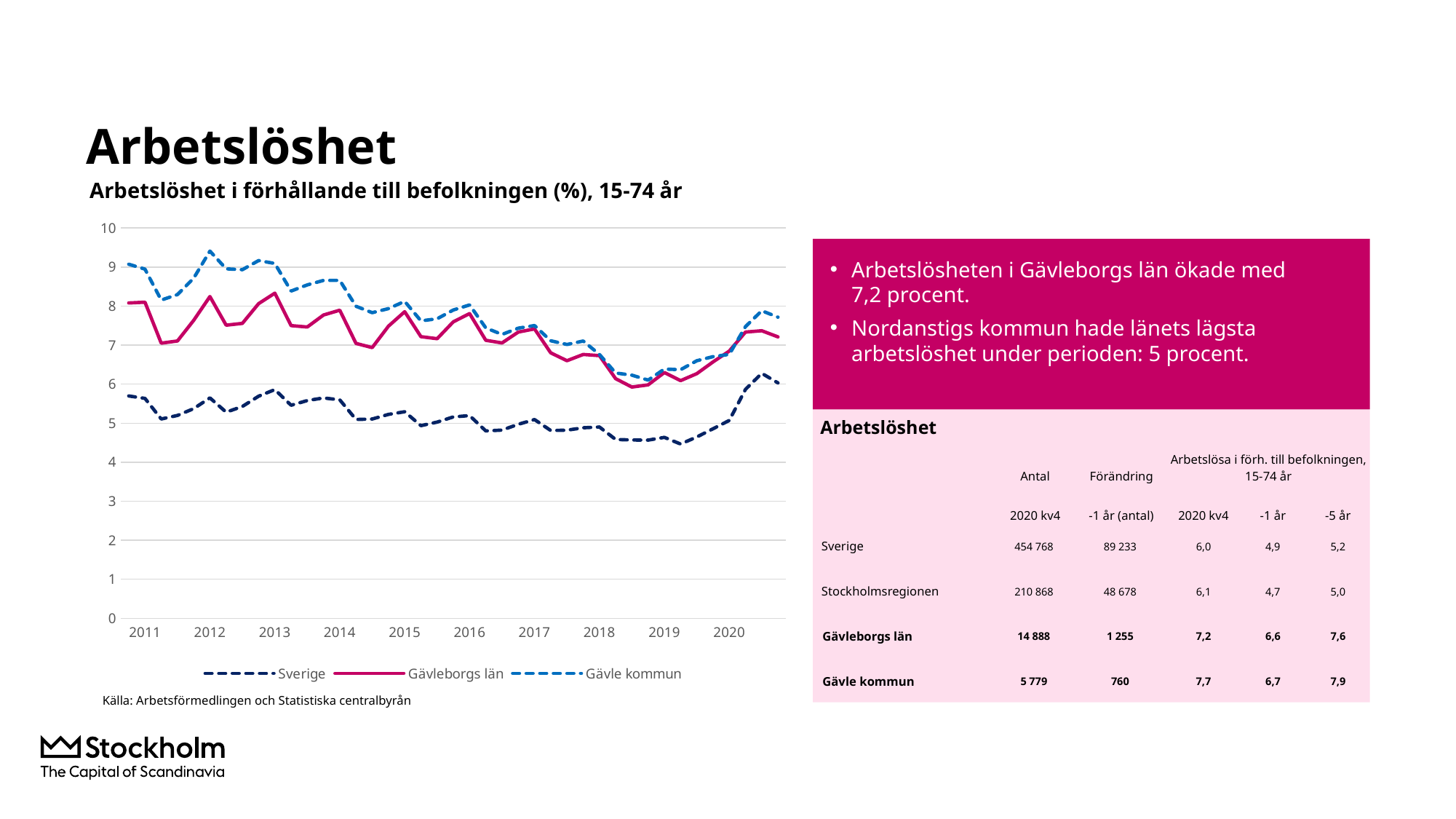
What kind of chart is shown on the slide? Line chart Is the value for Sverige in 2019 greater or less than 5? less How many years are labelled on the x axis of the chart? 10 Is the value for Sverige at the start of 2011 greater or less than 5? greater How many series does the chart legend list? 3 Which series has the lowest values throughout the chart? Sverige What is the title of the chart? Arbetslöshet i förhållande till befolkningen (%), 15-74 år In 2012, which series is higher: Sverige or Gävle kommun? Gävle kommun Which series are listed in the chart legend? Sverige, Gävleborgs län, Gävle kommun Does the Gävleborgs län line rise or fall between 2013 and 2019? Fall Is the value for Gävle kommun at the end of 2020 greater or less than 7? greater